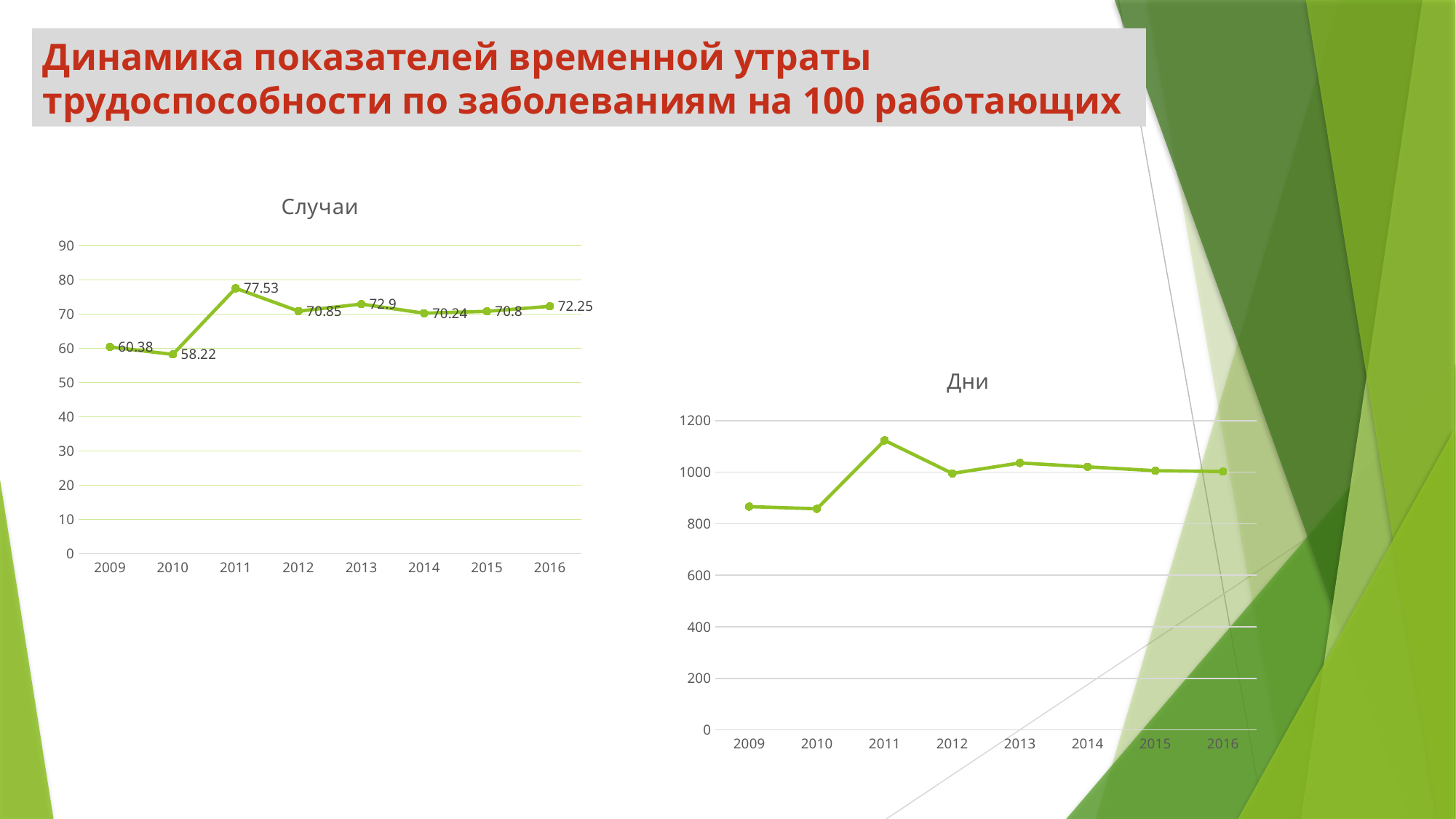
In the "Дни" chart, is the value for 2011 greater or less than 1000? greater In the "Случаи" chart, which year has the larger value, 2013 or 2015? 2013 In the "Случаи" chart, what is the difference between the values for 2011 and 2010? 19.31 In the "Случаи" chart, which year has the lowest value? 2010 In the "Случаи" chart, what is the value for 2011? 77.53 In the "Дни" chart, which year has the highest value? 2011 What kind of chart is the "Дни" chart? line chart How many years are plotted in the "Случаи" chart? 8 In the "Случаи" chart, which year has the highest value? 2011 In the "Случаи" chart, what is the value for 2010? 58.22 In the "Дни" chart, is the value for 2009 greater or less than 1000? less In the "Случаи" chart, what is the value for 2016? 72.25